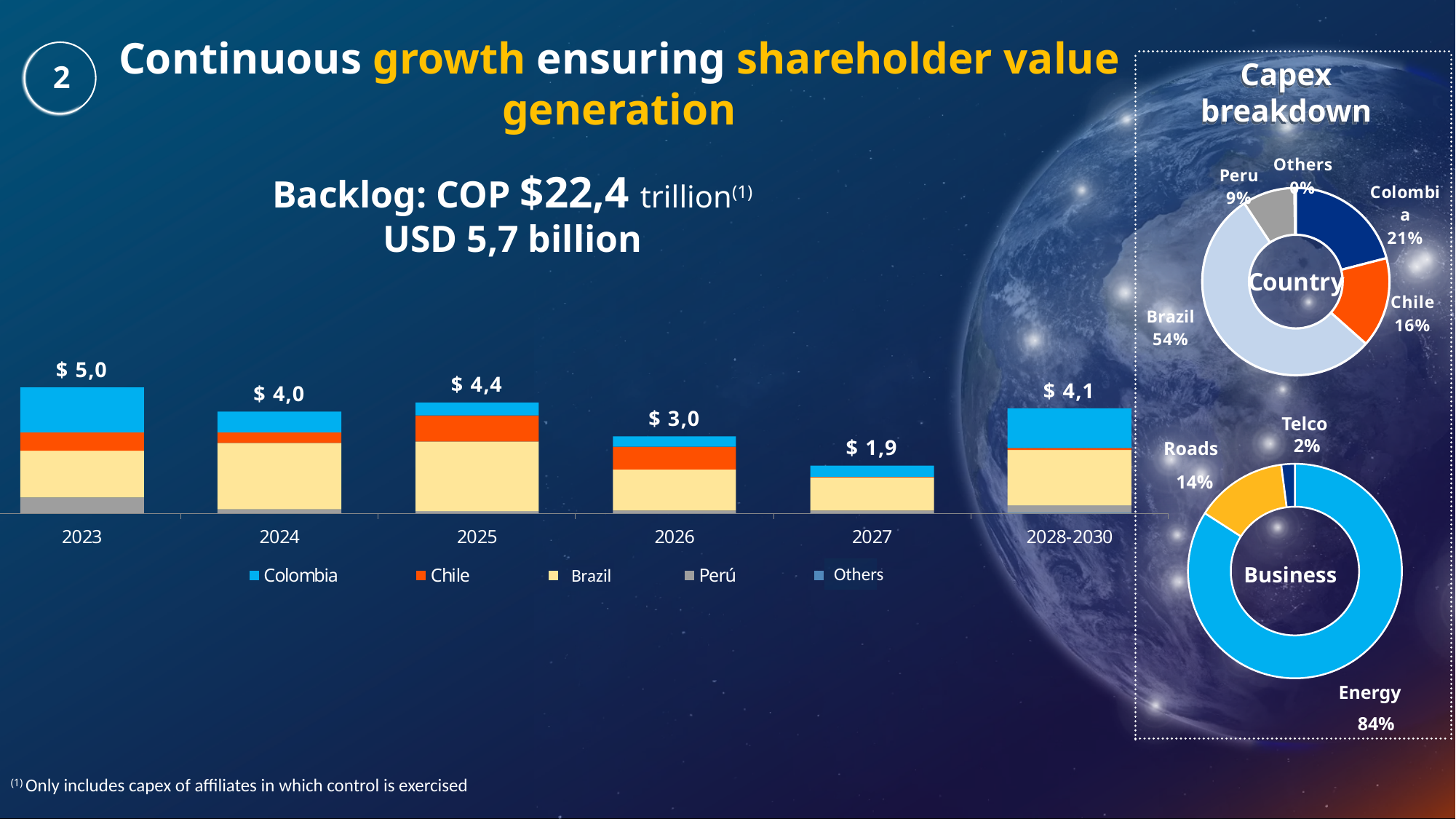
In the stacked bar chart, which year has the lowest total backlog? 2027 How many year categories are shown on the x axis of the stacked bar chart? 6 In the Business donut chart, what share of capex goes to Roads? 14% How many series does the legend of the stacked bar chart list? 5 In the Country donut chart, which country has the smallest non-zero share? Peru What kind of chart is used to show the backlog by year? Stacked bar chart In the stacked bar chart, what is the total value labelled for 2028-2030? $ 4,1 In the stacked bar chart, which total is larger, 2024 or 2028-2030? 2028-2030 In the stacked bar chart, what is the total backlog value labelled for 2023? $ 5,0 In the stacked bar chart, which year has the highest total backlog? 2023 In the stacked bar chart, what is the difference between the totals for 2025 and 2026? 1,4 In the Country donut chart, what share of capex goes to Brazil? 54%